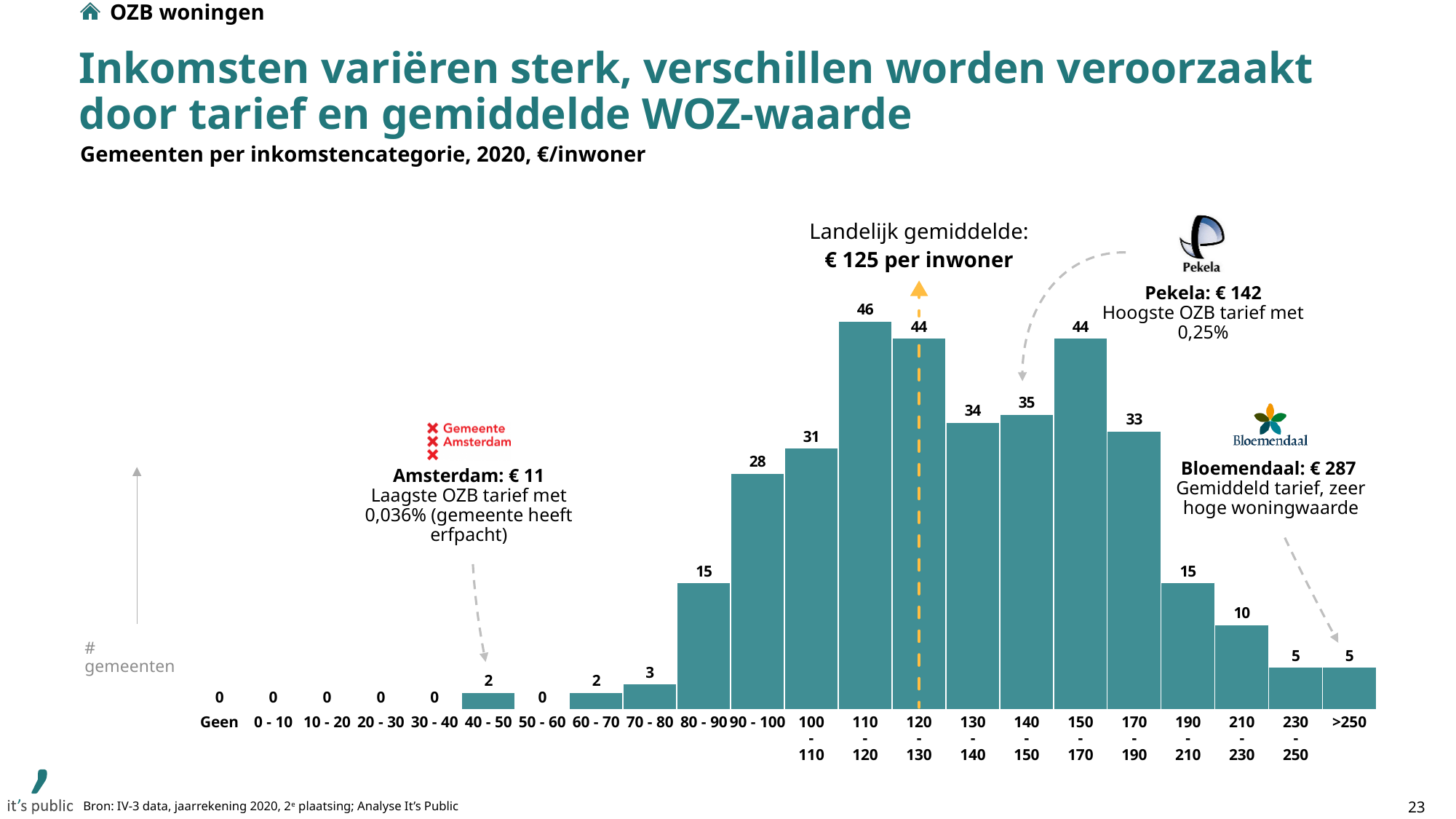
How many municipalities fall in the 80 - 90 income category? 15 How many municipalities fall in the >250 income category? 5 Which category has more municipalities, 90 - 100 or 190 - 210? 90 - 100 What is the difference between the number of municipalities in the 150 - 170 category and the 170 - 190 category? 11 How many municipalities fall in the 110 - 120 income category? 46 How many income categories are shown on the x axis? 22 Which income category has the highest number of municipalities? 110 - 120 What is the difference between the number of municipalities in the 110 - 120 category and the 120 - 130 category? 2 What type of chart is shown on the slide? bar chart Which category has more municipalities, 130 - 140 or 140 - 150? 140 - 150 What national average (Landelijk gemiddelde) is marked by the dashed line on the chart? € 125 per inwoner